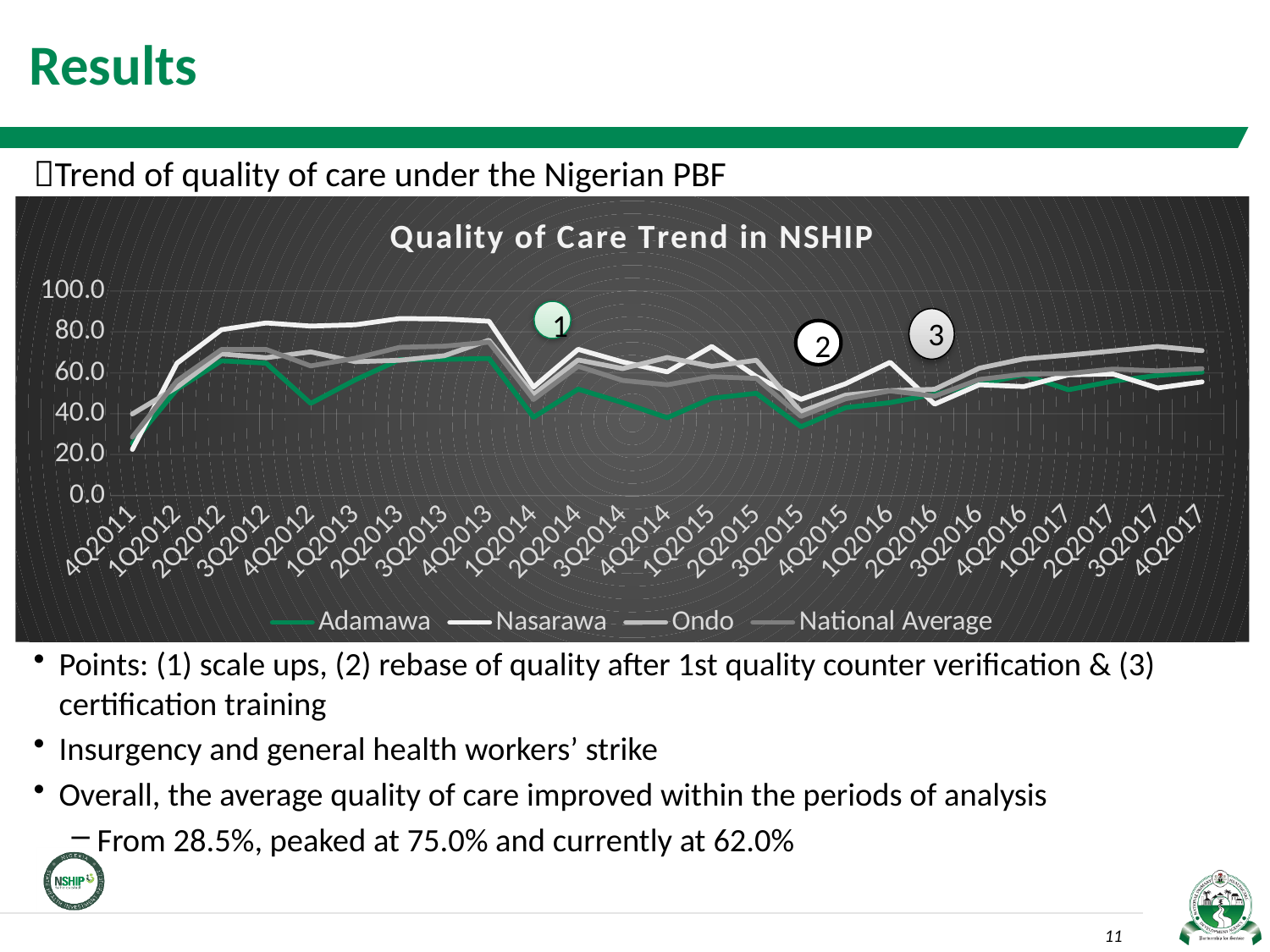
Which quarter is the first point on the x axis of the chart? 4Q2011 Is the value for Adamawa at 4Q2011 greater or less than 40.0? less Which series has the highest value at 2Q2013? Nasarawa Do the values for Adamawa rise or fall from 4Q2011 to 2Q2012? rise Is the value for Nasarawa at 3Q2013 greater or less than 80.0? greater Do the values for Nasarawa rise or fall from 4Q2013 to 1Q2014? fall At 3Q2013, which series has the larger value, Nasarawa or Adamawa? Nasarawa How many quarters are plotted along the x axis of the chart? 25 Is the value for Adamawa at 1Q2014 greater or less than 60.0? less What is the title of the chart? Quality of Care Trend in NSHIP What kind of chart is shown on the slide? line chart How many series does the chart legend list? 4